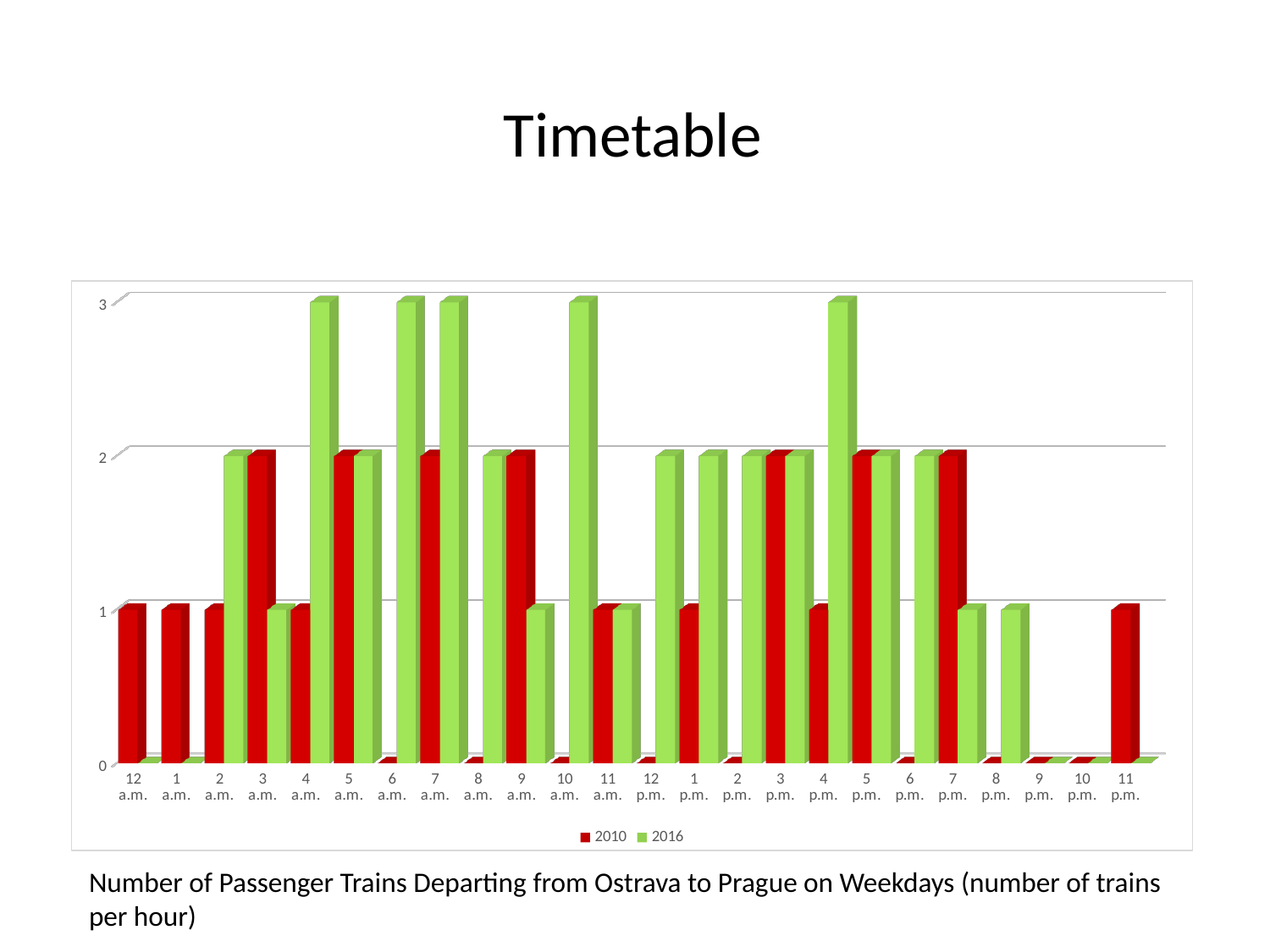
What is the highest value reached by the 2010 series? 2 What is the value for 2016 at 6 a.m.? 3 What is the value for 2010 at 7 p.m.? 2 How many series does the legend list? 2 Which series has the larger value at 4 a.m., 2010 or 2016? 2016 What is the value for 2016 at 8 p.m.? 1 What is the value for 2010 at 11 p.m.? 1 What kind of chart is shown on the slide? Bar chart What is the difference between the 2016 and 2010 values at 10 a.m.? 3 Which series has the larger value at 9 a.m., 2010 or 2016? 2010 How many hourly categories are shown on the x axis? 24 Which two series are shown in the legend? 2010 and 2016